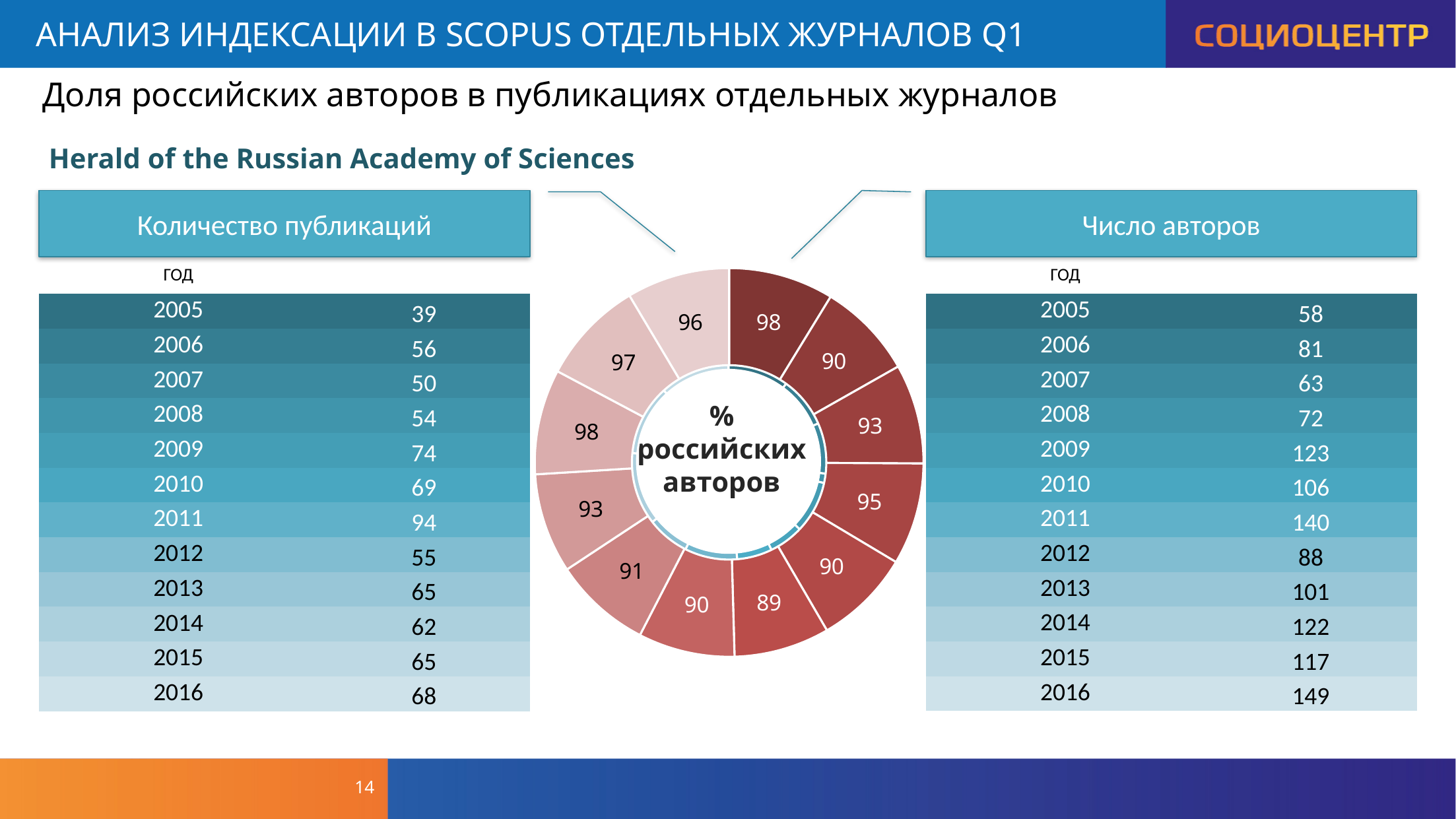
Which journal is named above the donut chart? Herald of the Russian Academy of Sciences What is the lowest value labelled on a segment of the donut chart? 89 How many segments does the donut chart have? 12 What is the highest value labelled on a segment of the donut chart? 98 What text is written in the centre of the donut chart? % российских авторов What value is labelled on the darkest red segment at the top right of the donut chart? 98 What value is labelled on the lightest segment at the top left of the donut chart? 96 How many segments of the donut chart are labelled 90? 3 What is the difference between the highest and lowest segment labels on the donut chart? 9 What kind of chart is shown in the centre of the slide? pie (donut) chart Which segment label is larger on the donut chart, 89 or 95? 95